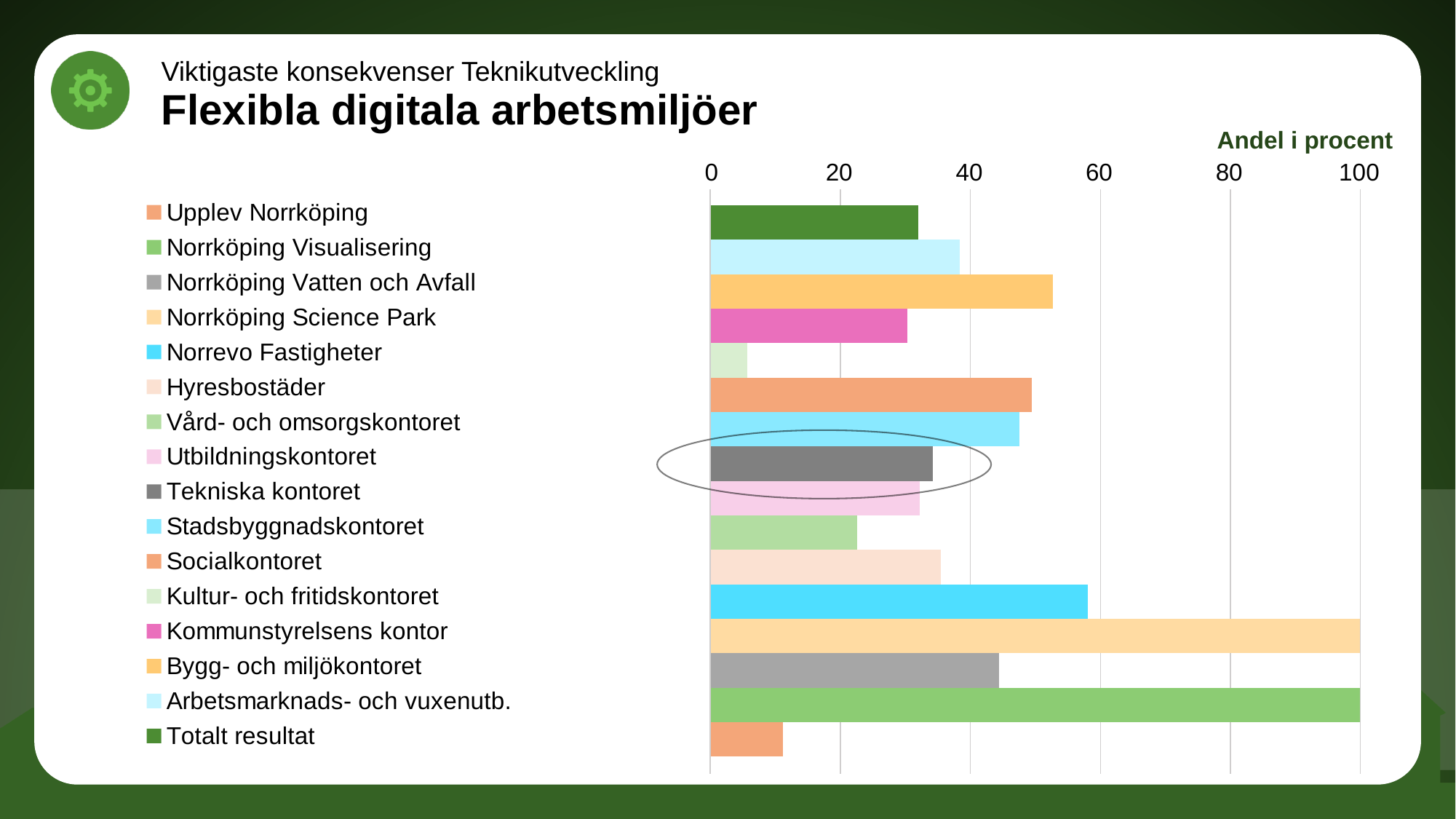
What kind of chart is shown on the slide? bar chart Which category has the lowest value? Kultur- och fritidskontoret Is the value for Upplev Norrköping greater or less than 20? less Which is larger, the value for Bygg- och miljökontoret or the value for Kommunstyrelsens kontor? Bygg- och miljökontoret Is the value for Totalt resultat greater or less than 40? less What is the value for Norrköping Science Park? 100 Which is larger, the value for Norrevo Fastigheter or the value for Socialkontoret? Norrevo Fastigheter What is the value for Norrköping Visualisering? 100 What label is shown above the horizontal axis of the chart? Andel i procent Is the value for Bygg- och miljökontoret greater or less than 40? greater How many categories (bars) does the chart show? 16